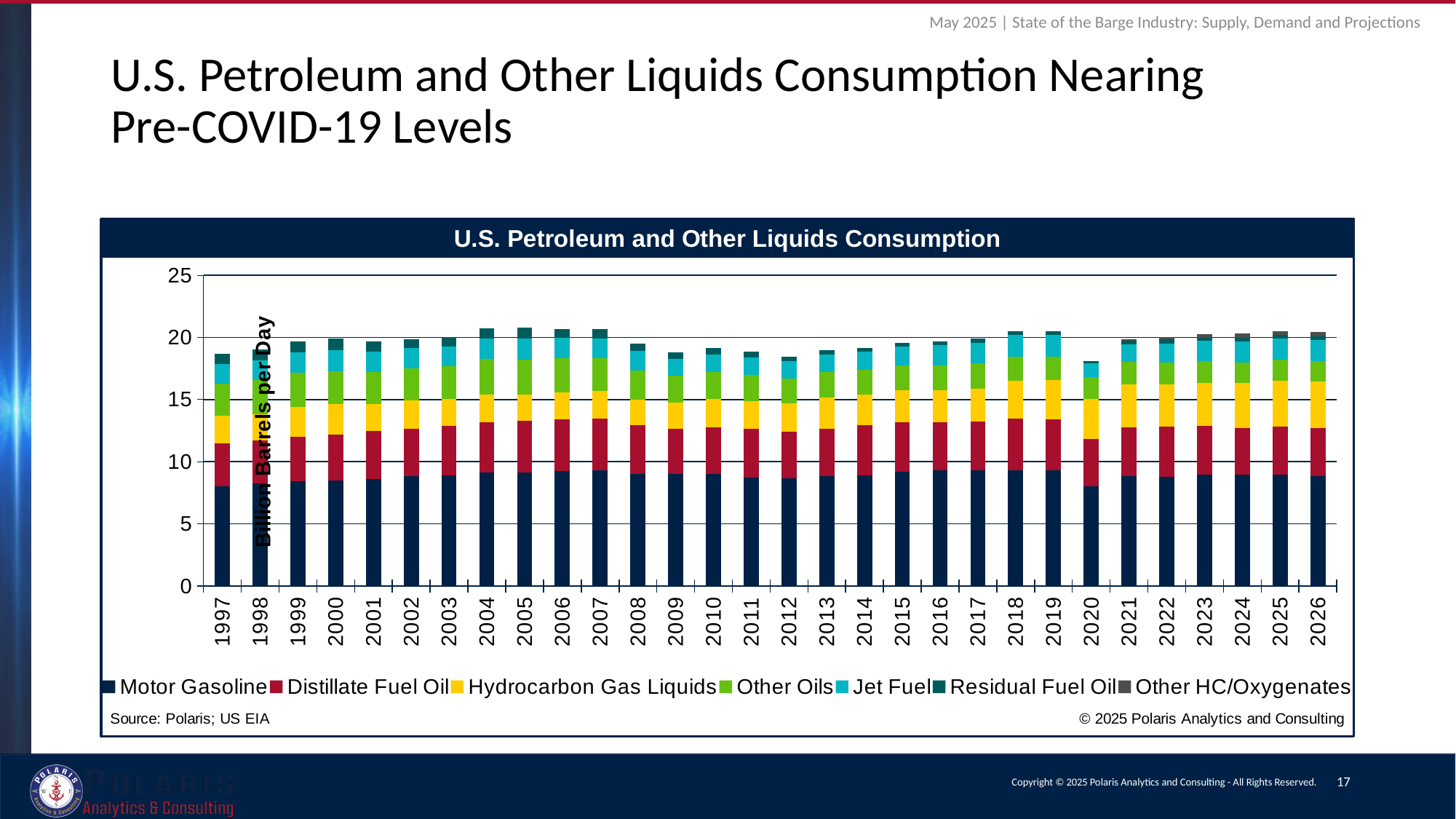
How many series does the chart legend list? 7 Is the total consumption for 1997 greater or less than 20 billion barrels per day? less How many years are shown along the x axis of the chart? 30 Is the Motor Gasoline value for 2020 greater or less than 10 billion barrels per day? less Which year has the larger total consumption, 2019 or 2020? 2019 What is the label on the chart's y axis? Billion Barrels per Day Which year has the lowest total consumption among the years 2008 through 2026? 2020 Does total consumption rise or fall from 2007 to 2012? Fall Is the total consumption for 2005 greater or less than 20 billion barrels per day? greater What is the title of the chart? U.S. Petroleum and Other Liquids Consumption What type of chart is shown on the slide? Stacked bar chart